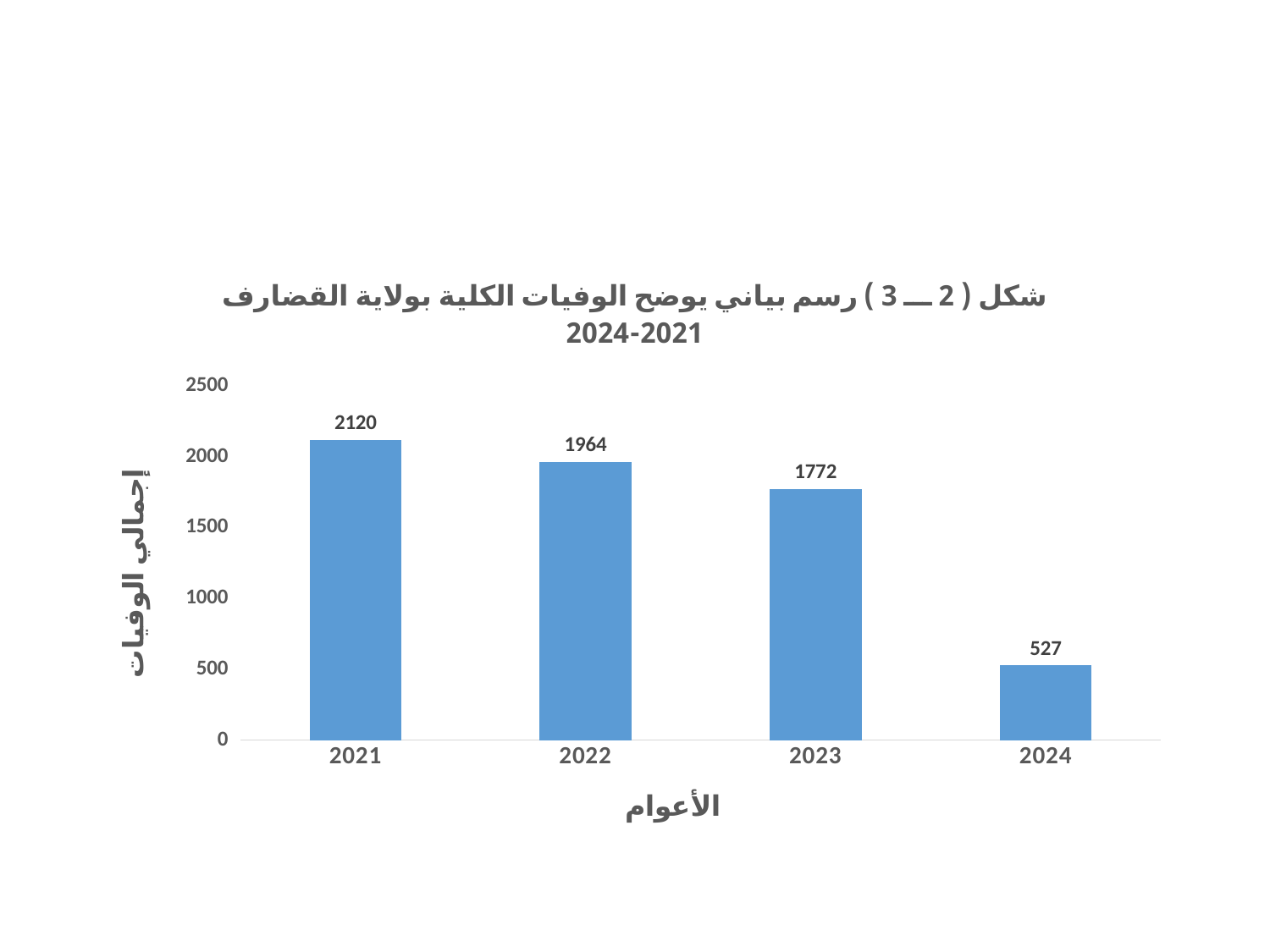
What kind of chart is this? Bar chart What is the value for 2021? 2120 What is the value for 2023? 1772 Do the values rise or fall from 2021 to 2024? Fall What is the difference between the values for 2021 and 2022? 156 What is the value for 2022? 1964 What is the value for 2024? 527 How many years are shown on the x axis? 4 Which is larger, the value for 2022 or the value for 2023? 2022 What is the difference between the values for 2023 and 2024? 1245 Which year has the highest value? 2021 Which year has the lowest value? 2024